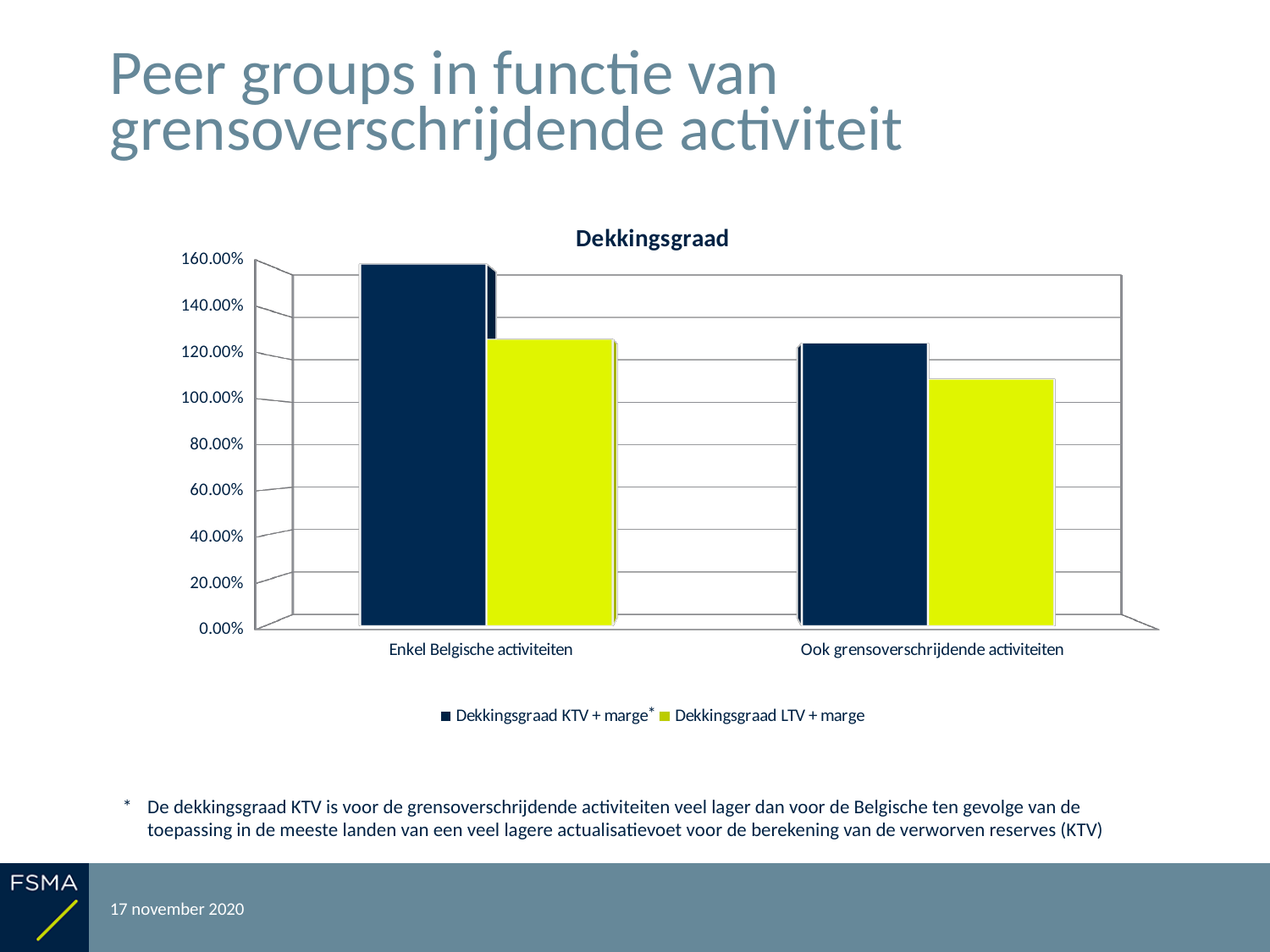
Is the Dekkingsgraad LTV + marge value for Ook grensoverschrijdende activiteiten greater or less than 120.00%? less Which category has the higher Dekkingsgraad LTV + marge value: Enkel Belgische activiteiten or Ook grensoverschrijdende activiteiten? Enkel Belgische activiteiten Which colour represents the Dekkingsgraad LTV + marge series in the chart? yellow-green How many series does the chart legend list? 2 How many categories are shown on the x axis of the chart? 2 Is the Dekkingsgraad KTV + marge value for Enkel Belgische activiteiten greater or less than 140.00%? greater What is the title of the chart? Dekkingsgraad For Enkel Belgische activiteiten, which is larger: Dekkingsgraad KTV + marge or Dekkingsgraad LTV + marge? Dekkingsgraad KTV + marge Which category and series has the lowest bar in the chart? Dekkingsgraad LTV + marge for Ook grensoverschrijdende activiteiten Which category and series has the highest bar in the chart? Dekkingsgraad KTV + marge for Enkel Belgische activiteiten What kind of chart is shown on the slide? bar chart Is the Dekkingsgraad KTV + marge value for Ook grensoverschrijdende activiteiten greater or less than 100.00%? greater